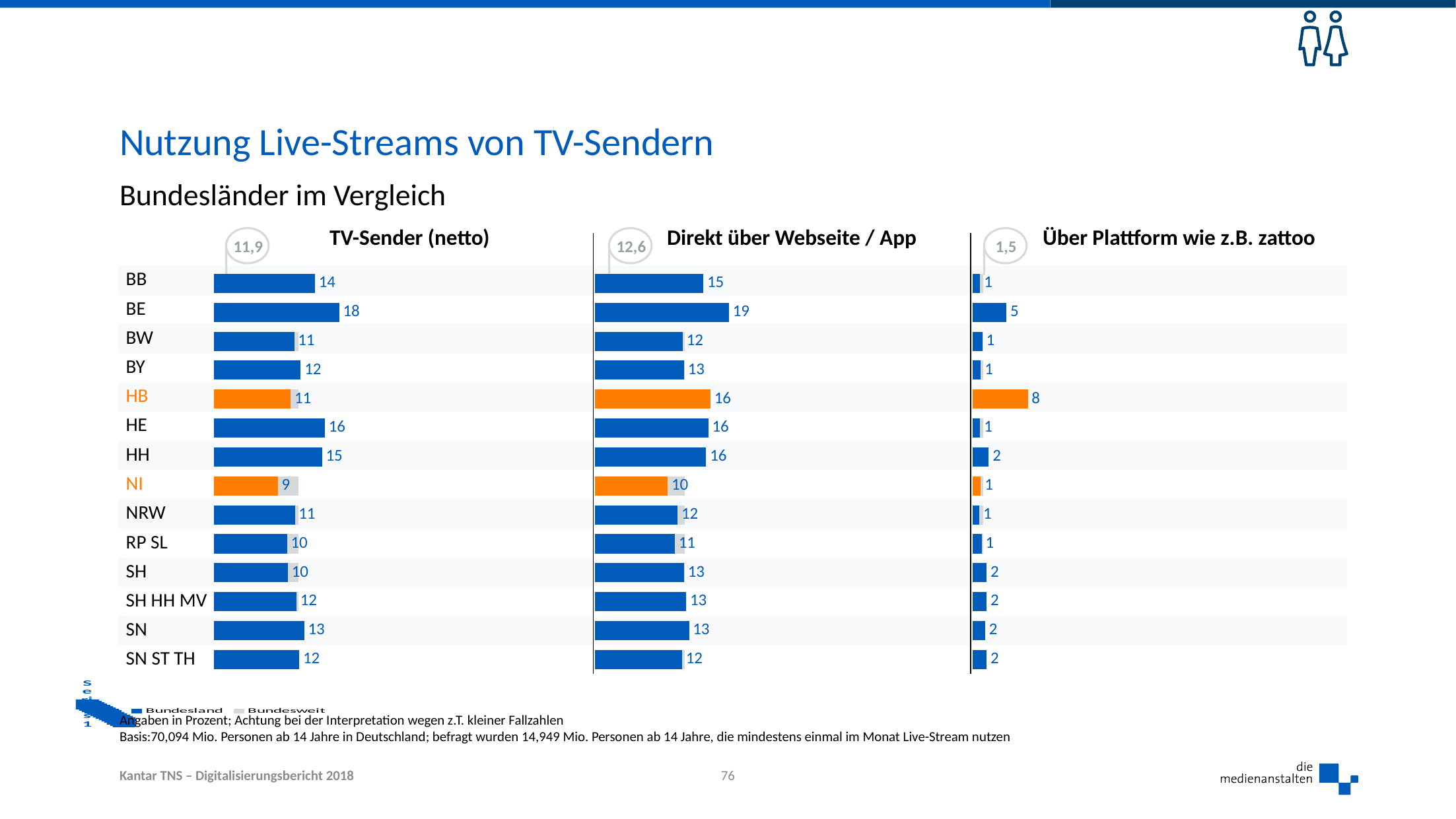
How many Bundesländer (categories) are shown in the "TV-Sender (netto)" chart? 14 In the "Direkt über Webseite / App" chart, which Bundesland has the lowest value? NI What kind of chart is the "Direkt über Webseite / App" chart? bar chart In the "Über Plattform wie z.B. zattoo" chart, what is the value for HB? 8 In the "Direkt über Webseite / App" chart, what is the difference between the values for BE and NI? 9 In the "TV-Sender (netto)" chart, what is the value for BE? 18 In the "Über Plattform wie z.B. zattoo" chart, which is larger, the value for BE or the value for HH? BE What is the Bundesweit reference value shown at the top of the "Über Plattform wie z.B. zattoo" chart? 1,5 In the "TV-Sender (netto)" chart, what is the difference between the values for HE and SH? 6 In the "Direkt über Webseite / App" chart, what is the value for HB? 16 In the "TV-Sender (netto)" chart, which Bundesland has the highest value? BE In the "TV-Sender (netto)" chart, which Bundesland has the lowest value? NI